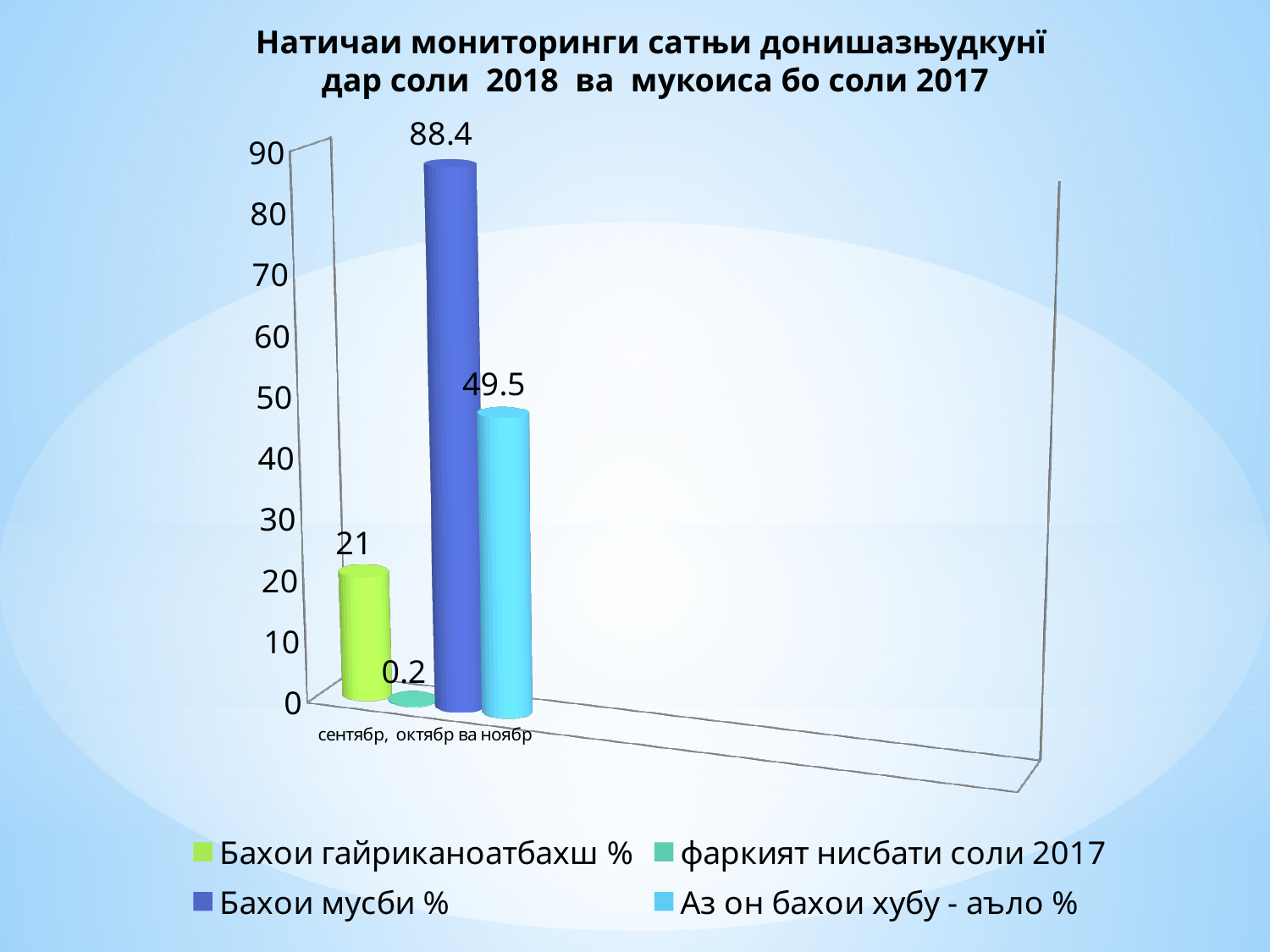
What kind of chart is shown on the slide? bar chart Which is larger, the value for "Бахои гайриканоатбахш %" or the value for "Аз он бахои хубу - аъло %"? Аз он бахои хубу - аъло % What is the value for the series "фаркият нисбати соли 2017"? 0.2 What is the highest value shown on the vertical axis? 90 What is the value for the series "Бахои гайриканоатбахш %"? 21 What is the value for the series "Бахои мусби %"? 88.4 What is the category label shown on the x axis? сентябр, октябр ва ноябр Which series has the highest value? Бахои мусби % What is the value for the series "Аз он бахои хубу - аъло %"? 49.5 How many series does the legend list? 4 Which series has the lowest value? фаркият нисбати соли 2017 What is the difference between the values for "Бахои мусби %" and "Аз он бахои хубу - аъло %"? 38.9